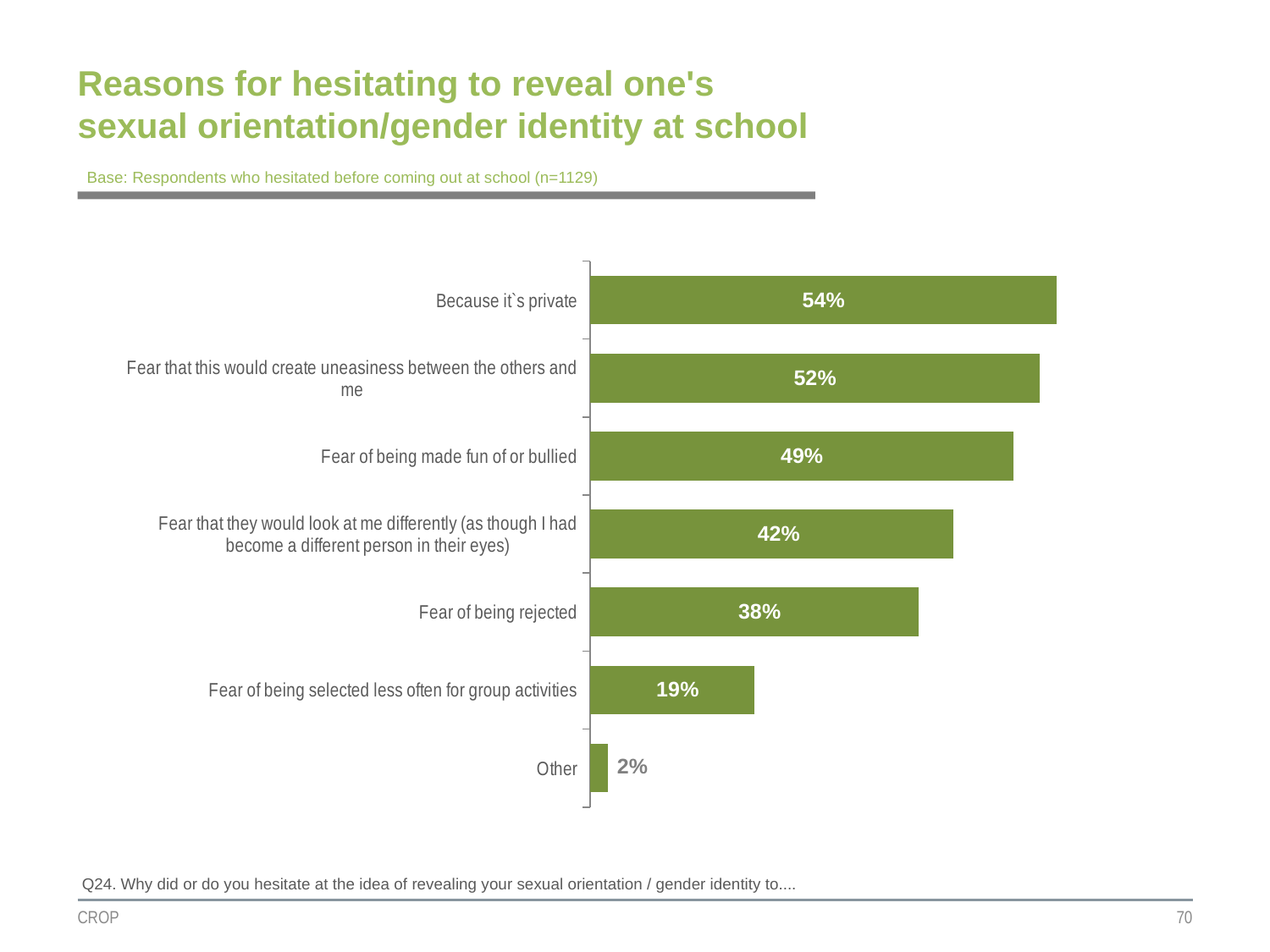
What is the difference in percentage points between "Fear of being rejected" and "Fear of being selected less often for group activities"? 19 Which reason has the lowest percentage on the chart? Other What is the base sample size (n) stated for the chart? n=1129 Which reason has the highest percentage on the chart? Because it`s private What is the value for "Fear of being made fun of or bullied"? 49% What percentage is shown for "Fear of being selected less often for group activities"? 19% What percentage of respondents cited "Because it`s private" as a reason for hesitating? 54% Which is larger: the value for "Fear of being made fun of or bullied" or the value for "Fear of being rejected"? Fear of being made fun of or bullied What is the value for "Fear that this would create uneasiness between the others and me"? 52% What kind of chart is shown on the slide? Bar chart What is the difference between "Because it`s private" and "Fear that they would look at me differently (as though I had become a different person in their eyes)"? 12 How many reasons (categories) are shown on the chart? 7